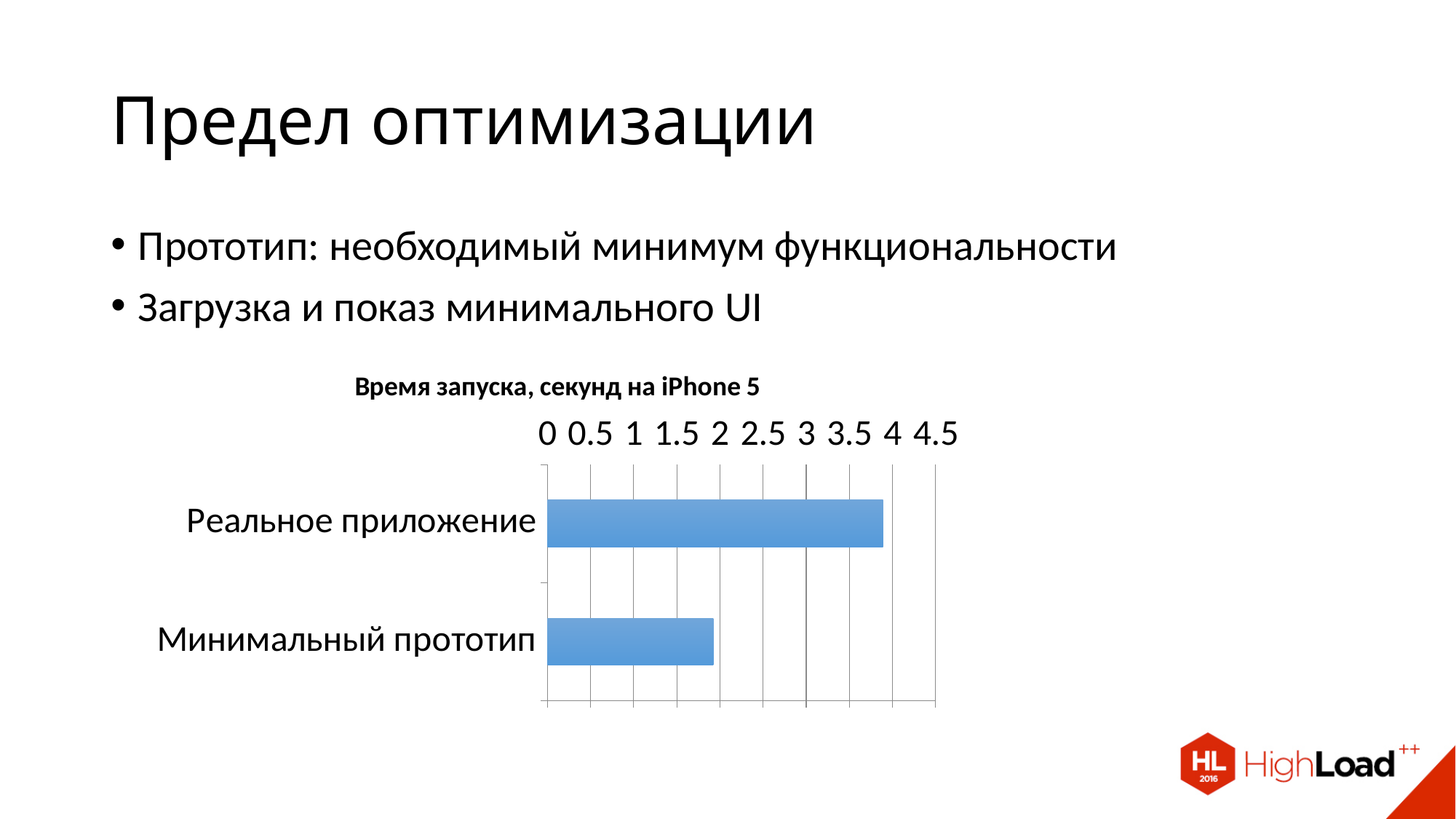
How many categories does the chart show? 2 What is the maximum value shown on the chart's value axis? 4.5 What is the title of the chart on the slide? Время запуска, секунд на iPhone 5 Is the value for Реальное приложение greater or less than 3.5? greater Is the value for Минимальный прототип greater or less than 1.5? greater Which category has the highest value in the chart? Реальное приложение What kind of chart is shown on the slide? bar chart Which is larger, the value for Реальное приложение or the value for Минимальный прототип? Реальное приложение Which category has the lowest value in the chart? Минимальный прототип Is the value for Реальное приложение greater or less than 4? less